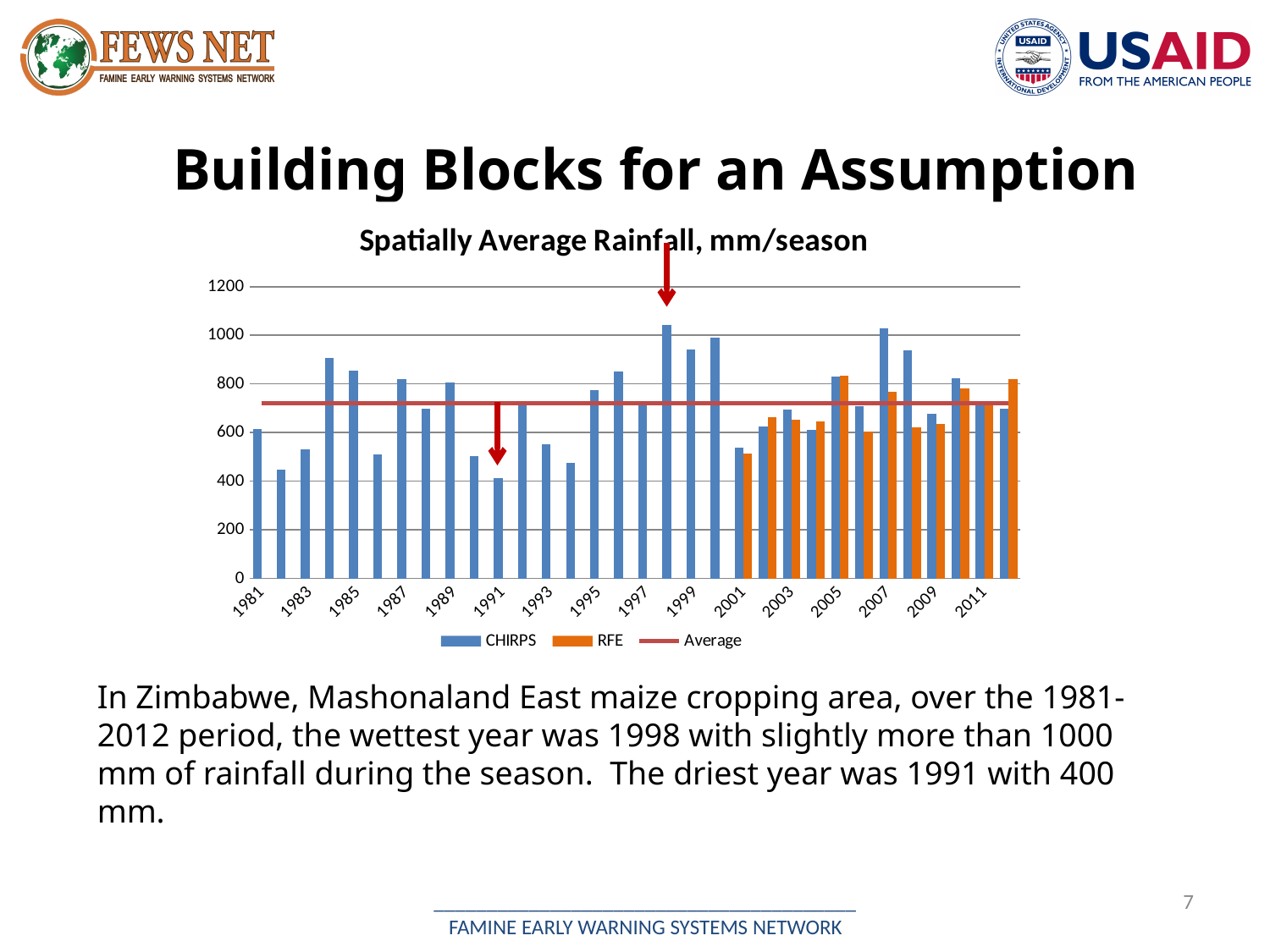
Is the CHIRPS value for 1991 greater or less than 600? less What kind of chart is shown on the slide? Bar chart Which is larger, the CHIRPS value for 1984 or the CHIRPS value for 1982? 1984 Which year has the lowest CHIRPS rainfall value in the chart? 1991 Is the CHIRPS value for 1998 greater or less than 1000? greater What is the title of the chart? Spatially Average Rainfall, mm/season How many series does the chart legend list? 3 What is the highest value shown on the y axis of the chart? 1200 Which series is drawn in orange in the chart? RFE Which year has the highest CHIRPS rainfall value in the chart? 1998 Is the RFE value for 2006 greater or less than 800? less